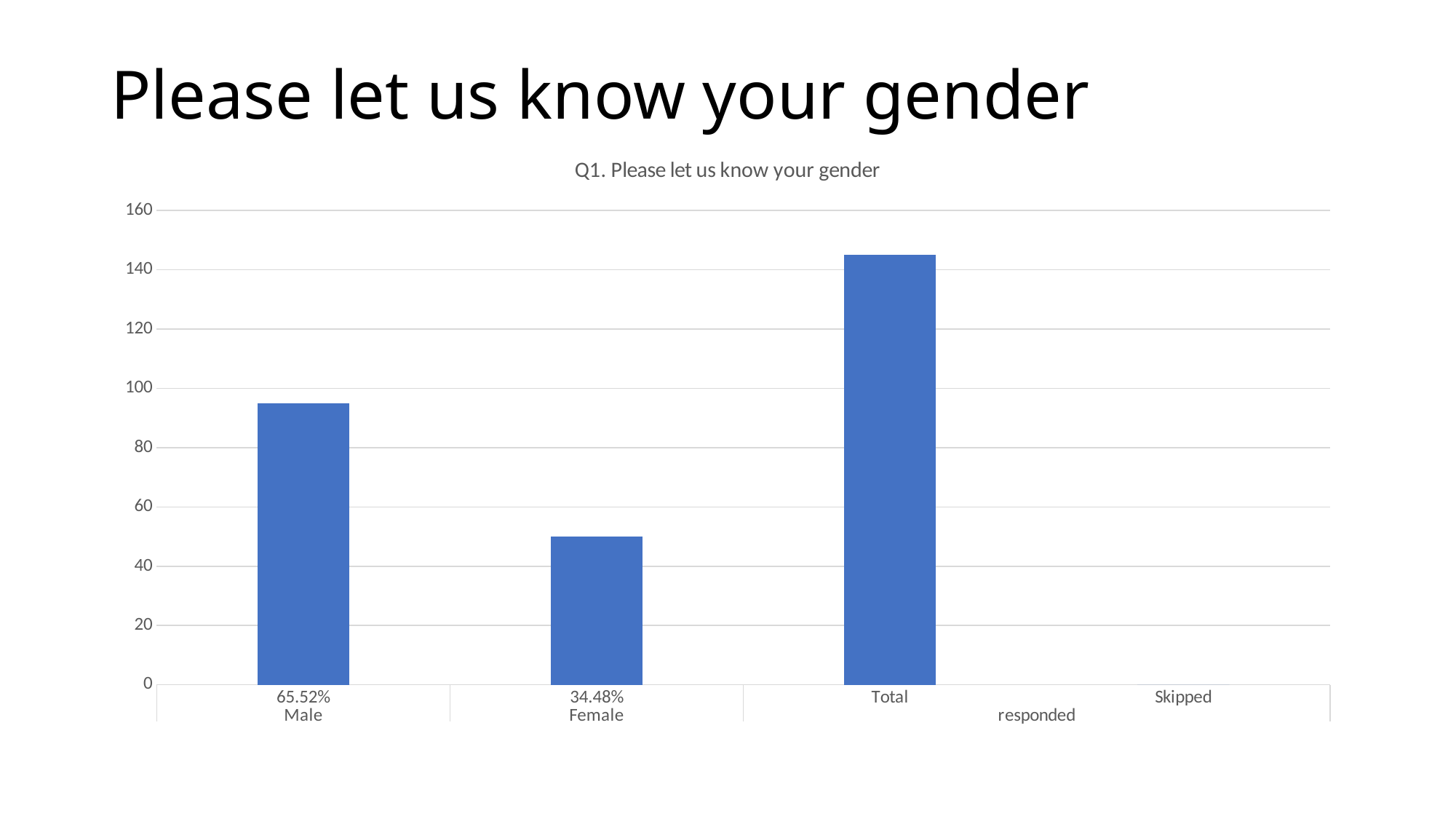
Is the value for Male greater or less than 80? greater What is the title of the chart? Q1. Please let us know your gender Is the value for Male greater or less than 100? less Is the value for Female greater or less than 60? less What kind of chart is shown on the slide? bar chart Which is larger, the value for Male or the value for Female? Male Which category has the tallest bar? Total responded What percentage is printed under the Female category label? 34.48% What percentage is printed under the Male category label? 65.52% Which is larger, the value for Total responded or the value for Male? Total responded